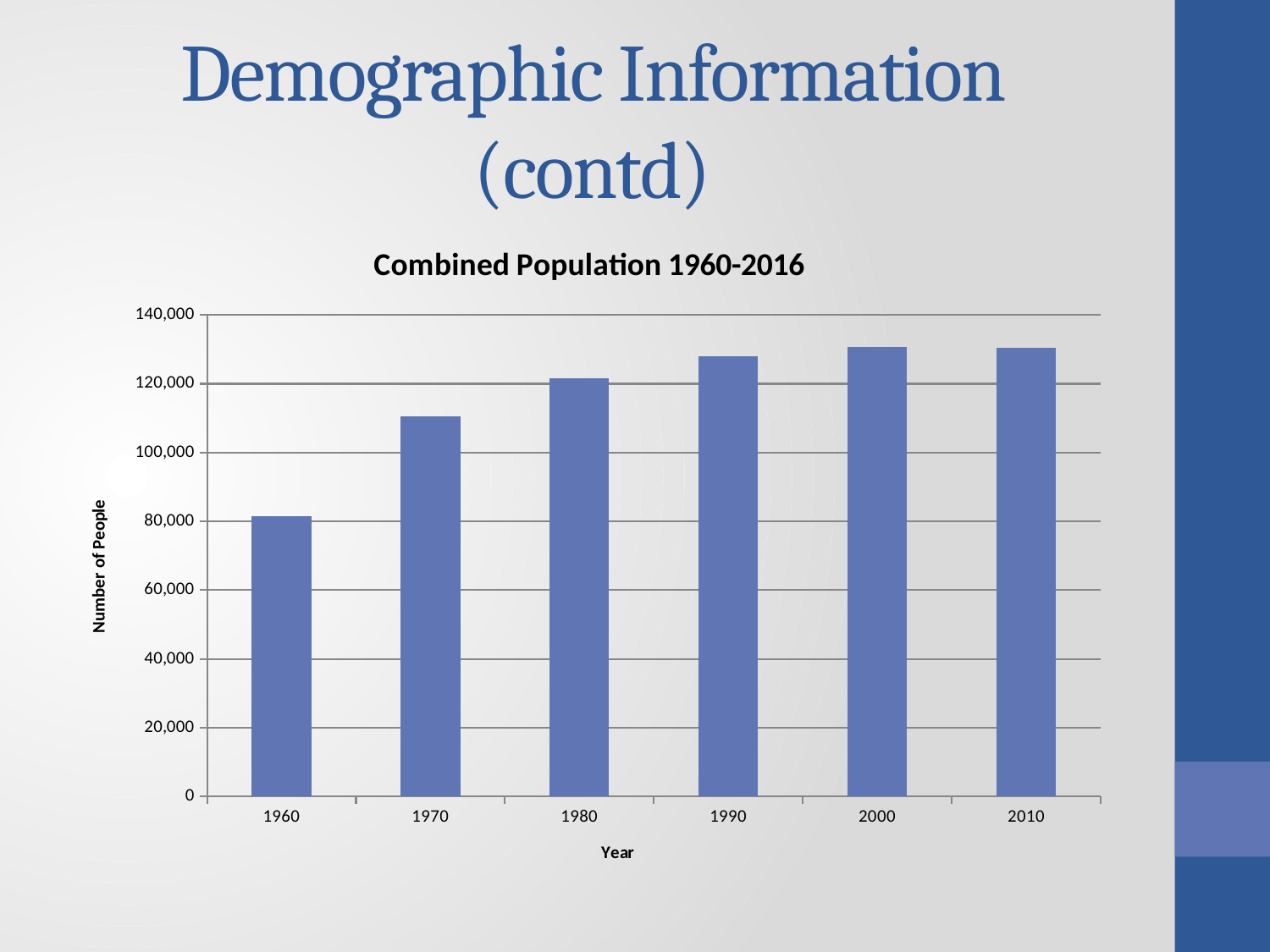
Is the value for 1990 greater or less than 120,000? greater Which year has the lowest combined population? 1960 Which is larger, the value for 1980 or the value for 1990? 1990 Is the value for 1970 greater or less than 100,000? greater What kind of chart is shown on the slide? bar chart What is the label on the vertical axis of the chart? Number of People Is the value for 2010 greater or less than 140,000? less How many years are plotted in the chart? 6 What is the title of the chart? Combined Population 1960-2016 Which is larger, the value for 1960 or the value for 1970? 1970 Do the values generally rise or fall from 1960 to 2010? rise